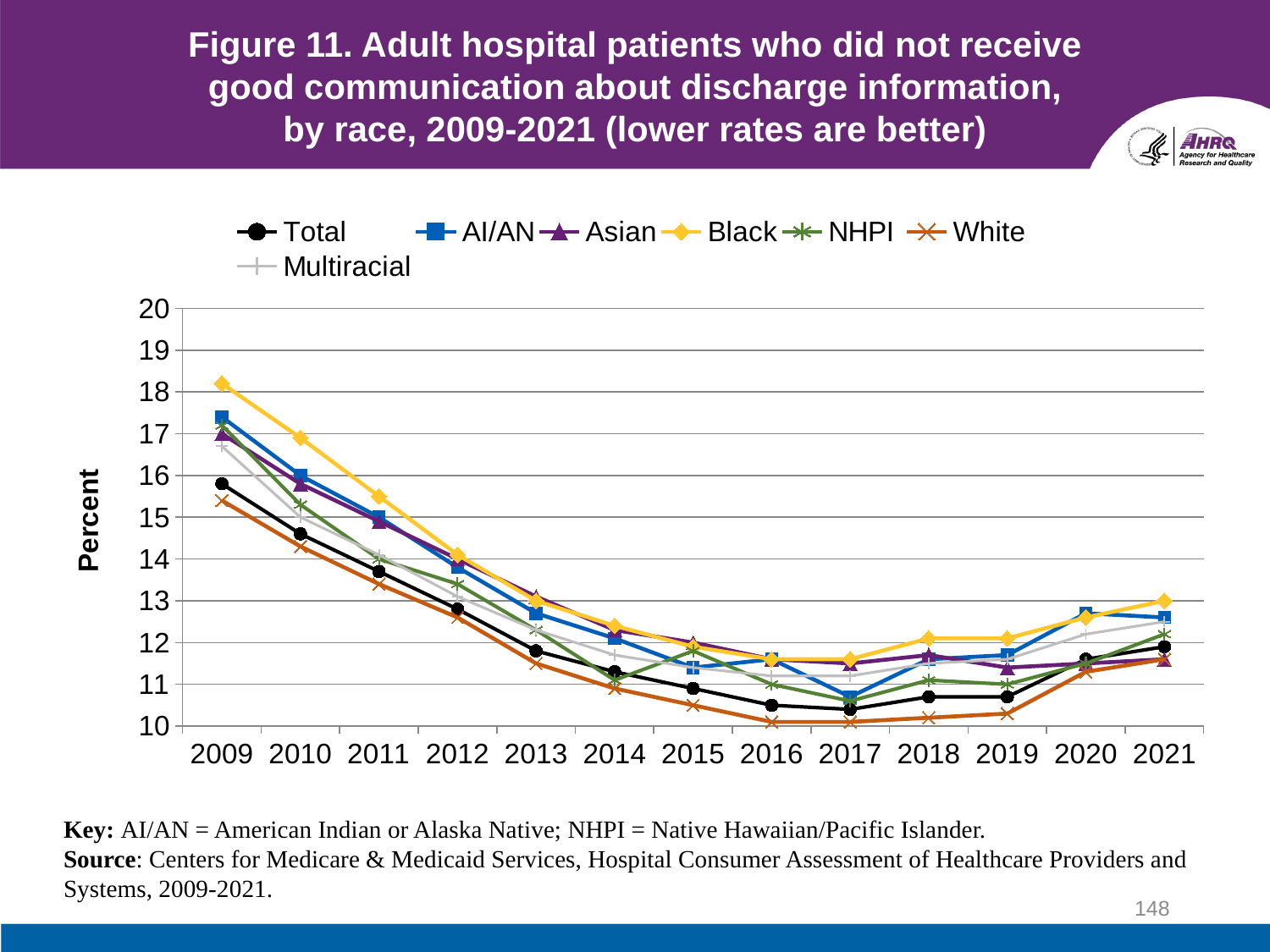
Is the value for White in 2016 greater or less than 11? less In 2021, which is larger: the value for Black or the value for White? Black Which race group had the highest rate in 2009? Black Which race group had the lowest rate in 2009? White Is the value for Black in 2009 greater or less than 17? greater Is the value for Total in 2009 greater or less than 15? greater How many series does the legend list? 7 How many years are plotted along the x axis? 13 Did the rate for Total rise or fall from 2017 to 2021? rise What kind of chart is shown on the slide? line chart Did the rate for Black rise or fall from 2009 to 2016? fall